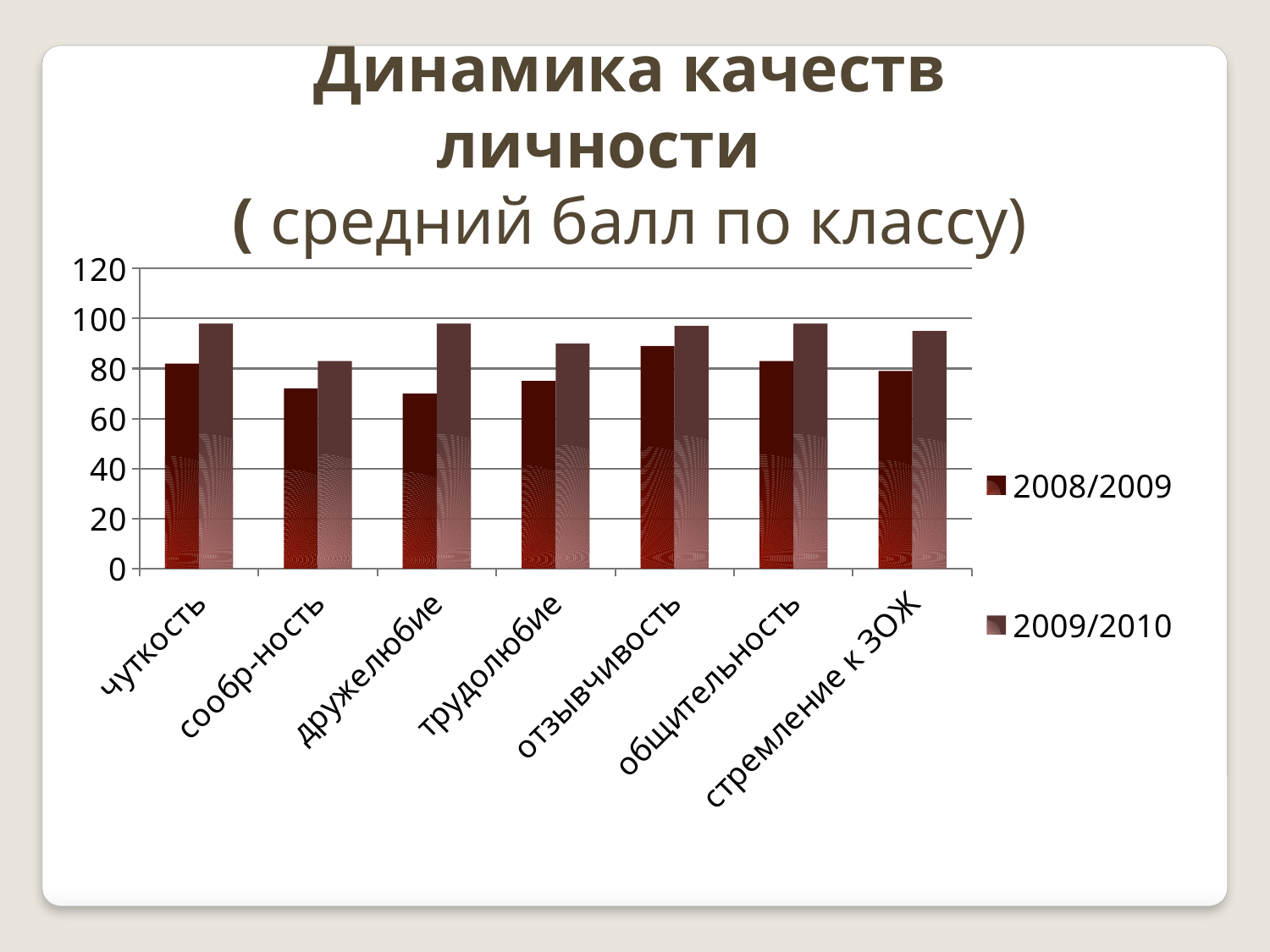
How many categories are shown on the x axis of the chart? 7 Which series does the legend list first? 2008/2009 Is the 2008/2009 value for трудолюбие greater or less than 80? less Is the 2009/2010 value for стремление к ЗОЖ greater or less than 80? greater Which category has the lowest value for the 2009/2010 series? сообр-ность For чуткость, which series has the larger value, 2008/2009 or 2009/2010? 2009/2010 Is the 2008/2009 value for отзывчивость greater or less than 80? greater For дружелюбие, which series has the larger value, 2008/2009 or 2009/2010? 2009/2010 Which category has the highest value for the 2008/2009 series? отзывчивость What kind of chart is shown on the slide? bar chart How many series does the legend list? 2